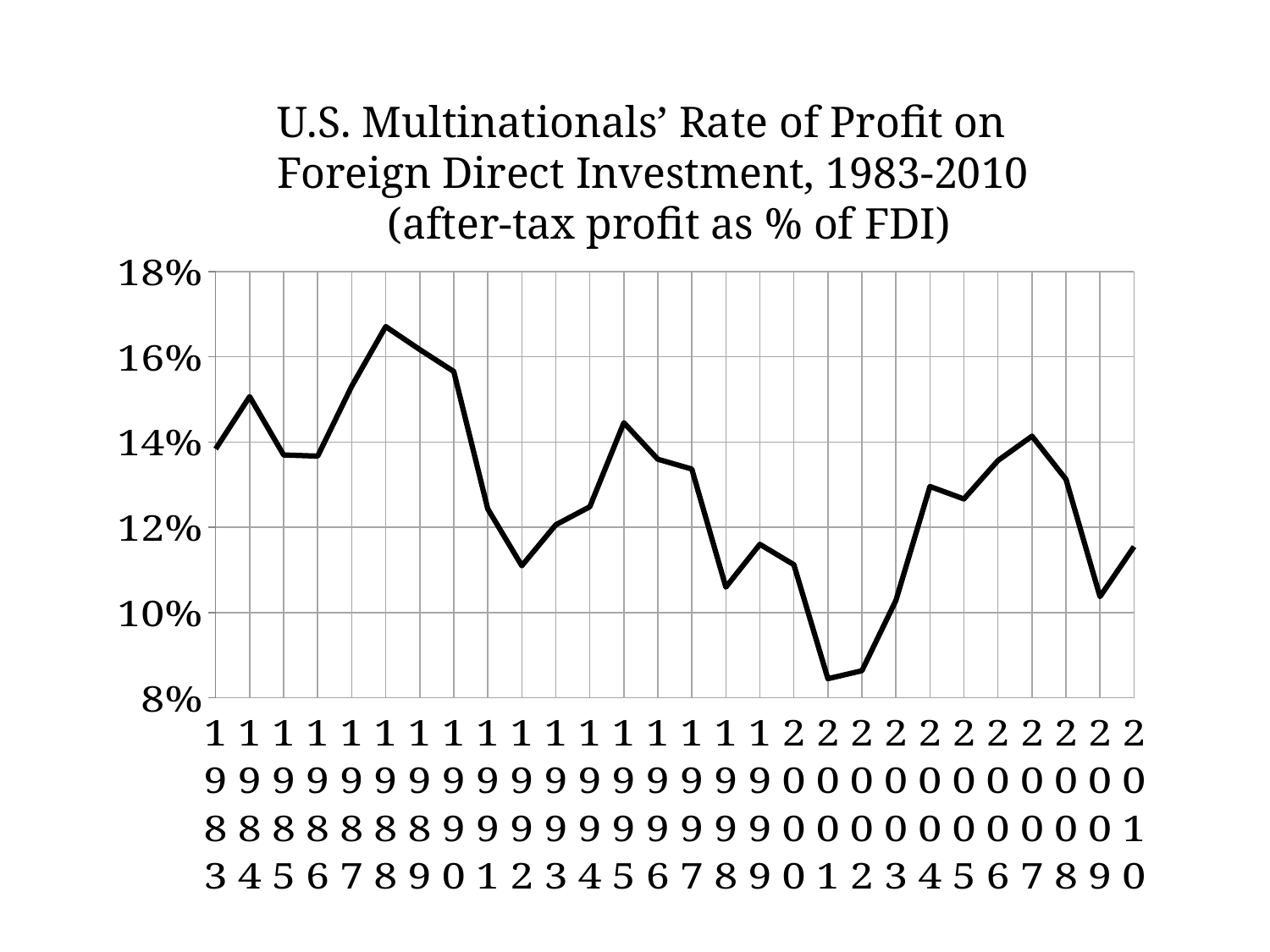
In which year was the rate of profit on foreign direct investment highest? 1988 Which year has the larger rate of profit, 2007 or 2009? 2007 What kind of chart is shown on the slide? line chart Is the value for 1988 greater or less than 16%? greater What is the title of the chart? U.S. Multinationals' Rate of Profit on Foreign Direct Investment, 1983-2010 (after-tax profit as % of FDI) Is the value for 2001 greater or less than 10%? less How many years (data points) are plotted on the chart? 28 Is the value for 2009 greater or less than 12%? less Does the rate of profit rise or fall from 1988 to 1992? fall Which year has the larger rate of profit, 1988 or 2001? 1988